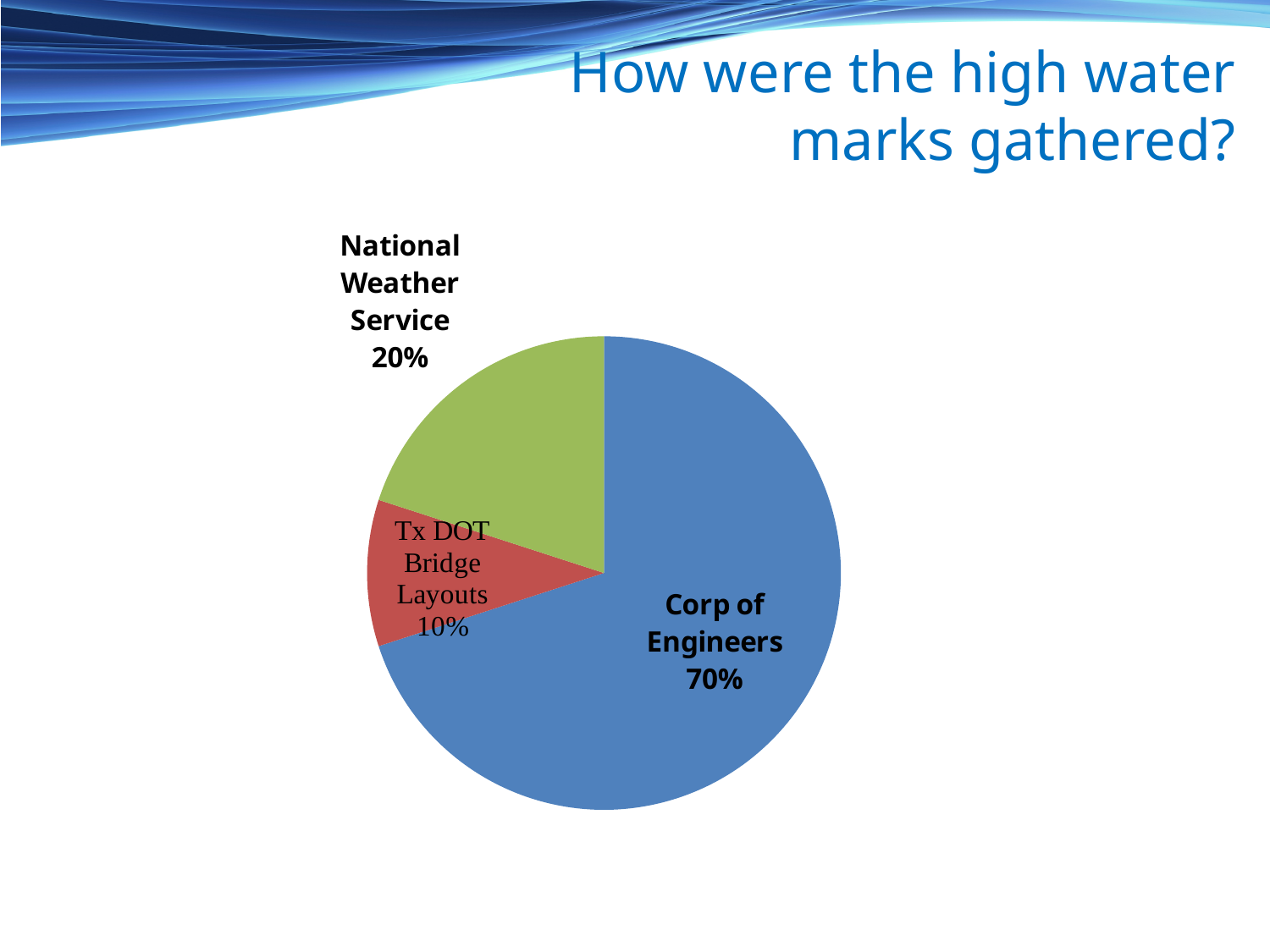
What is the difference in percentage points between the Corp of Engineers share and the National Weather Service share? 50 What share of the high water marks came from Tx DOT Bridge Layouts? 10% How many slices does the pie chart have? 3 What is the title of the slide containing the pie chart? How were the high water marks gathered? What colour is the Corp of Engineers slice? blue Which source accounts for the largest share of the pie? Corp of Engineers Which is larger, the National Weather Service share or the Tx DOT Bridge Layouts share? National Weather Service Which source accounts for the smallest share of the pie? Tx DOT Bridge Layouts What share of the high water marks came from the Corp of Engineers? 70% What kind of chart is shown on the slide? pie chart What share of the high water marks came from the National Weather Service? 20% What is the combined share of the National Weather Service and Tx DOT Bridge Layouts? 30%